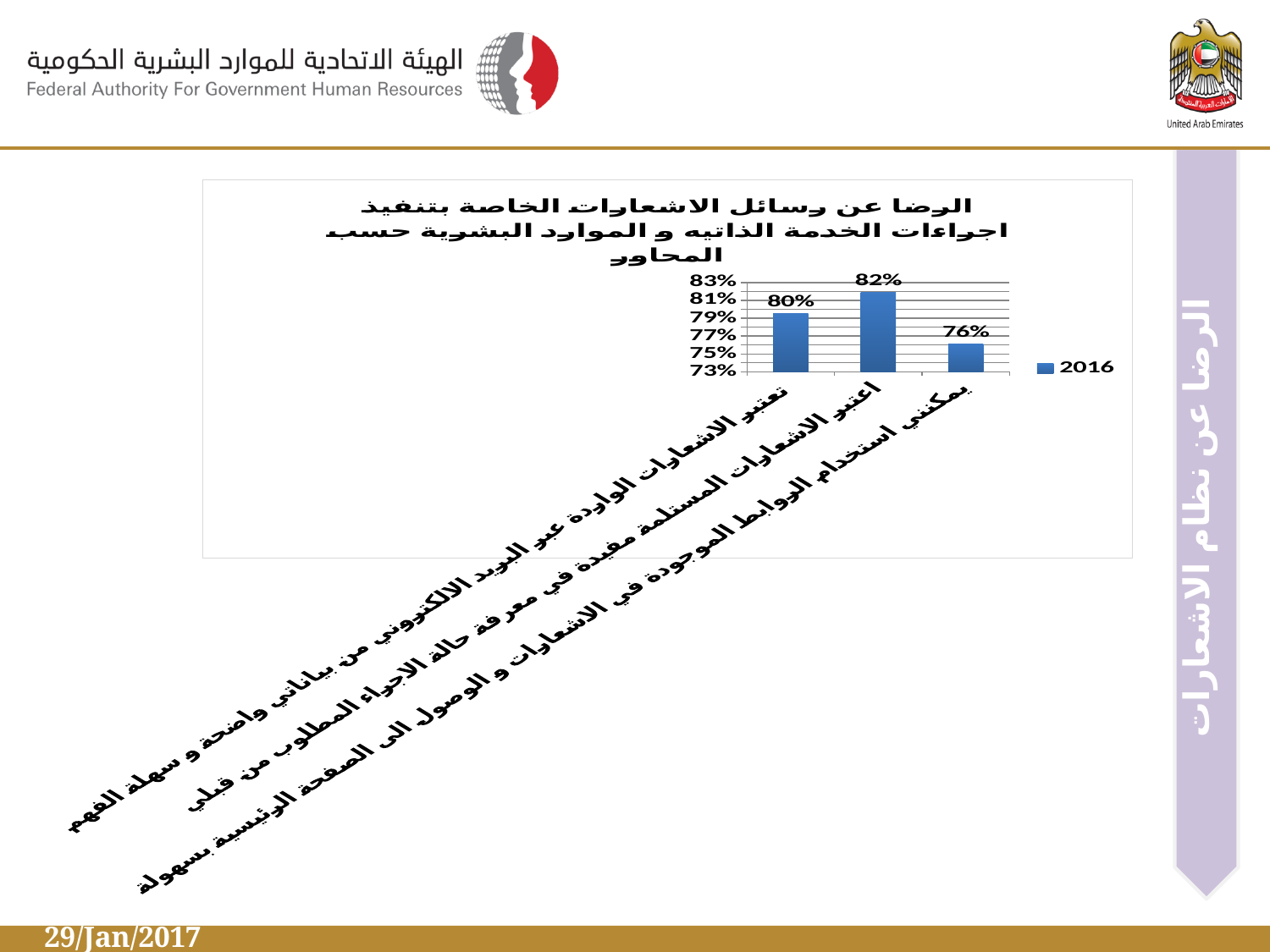
Which bar has the highest value? the middle bar (اعتبر الاشعارات المستلمة مفيدة في معرفة حالة الاجراء المطلوب من قبلي), 82% Is the value of the rightmost bar greater or less than 79%? less What is the value of the leftmost bar (الاشعارات الواردة عبر البريد الالكتروني واضحة و سهلة الفهم)? 80% What is the value of the rightmost bar (استخدام الروابط الموجودة في الاشعارات و الوصول الى الصفحة الرئيسية بسهولة)? 76% What is the difference between the highest value (82%) and the lowest value (76%)? 6% What series name appears in the chart legend? 2016 What type of chart is shown on the slide? bar chart Which bar has the lowest value? the rightmost bar (يمكنني استخدام الروابط الموجودة في الاشعارات و الوصول الى الصفحة الرئيسية بسهولة), 76% What is the value of the middle bar (الاشعارات المستلمة مفيدة في معرفة حالة الاجراء المطلوب)? 82% How many bars are plotted in the chart? 3 Which is larger: the value of the leftmost bar or the value of the rightmost bar? the leftmost bar (80%) How many series does the legend list? 1